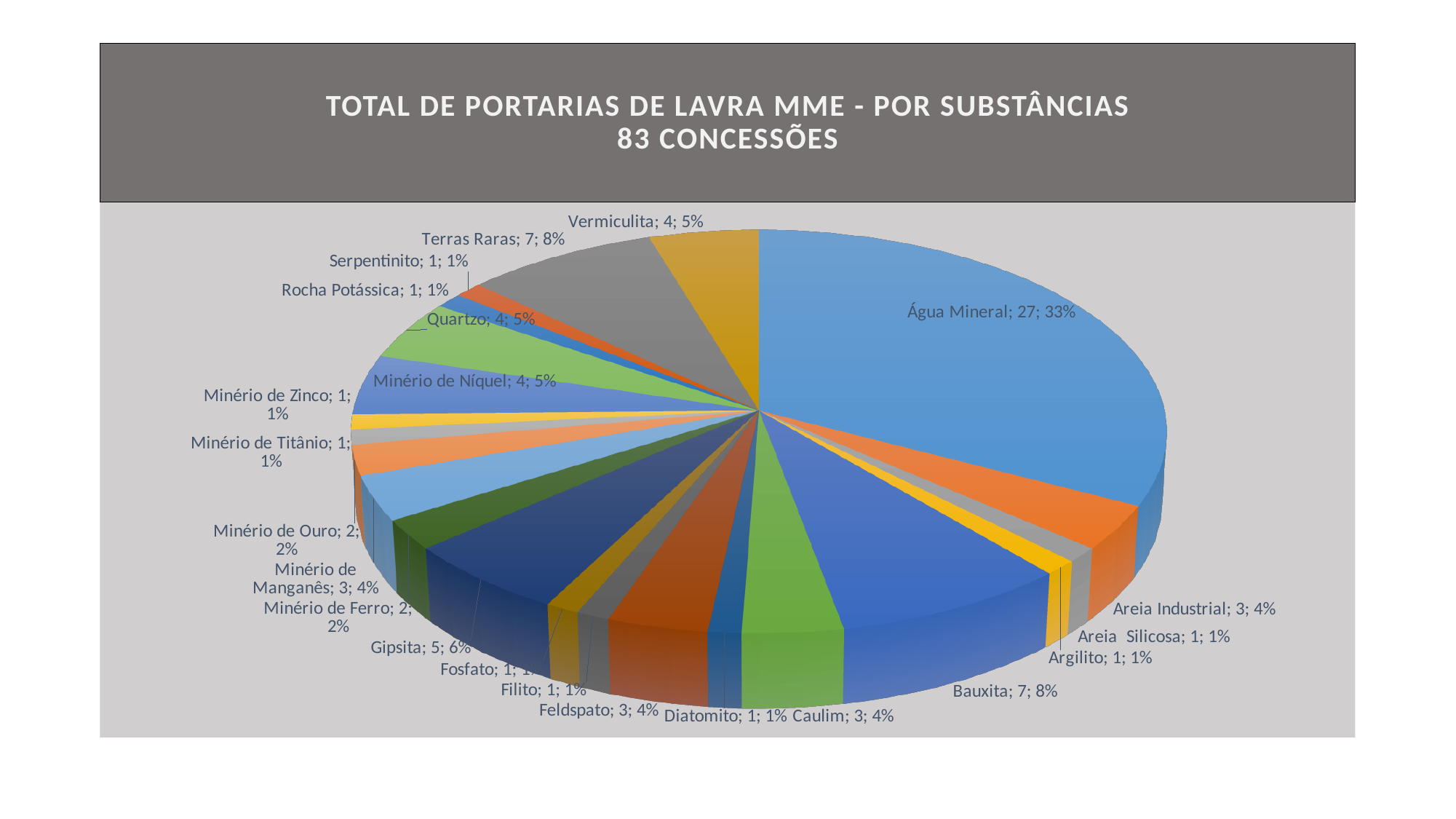
Which substance has the largest slice of the pie? Água Mineral What is the title of the chart? TOTAL DE PORTARIAS DE LAVRA MME - POR SUBSTÂNCIAS 83 CONCESSÕES What is the value shown for Vermiculita? 4 What is the difference between the values for Água Mineral and Bauxita? 20 What percentage share is shown for Terras Raras? 8% How many portarias de lavra does the Água Mineral slice represent? 27 How many substances (slices) are shown in the pie chart? 22 What is the value shown for Gipsita? 5 Which has the larger value, Minério de Níquel or Minério de Manganês? Minério de Níquel What kind of chart is shown on the slide? Pie chart What share of the pie does Água Mineral account for? 33% Which has the larger value, Gipsita or Quartzo? Gipsita